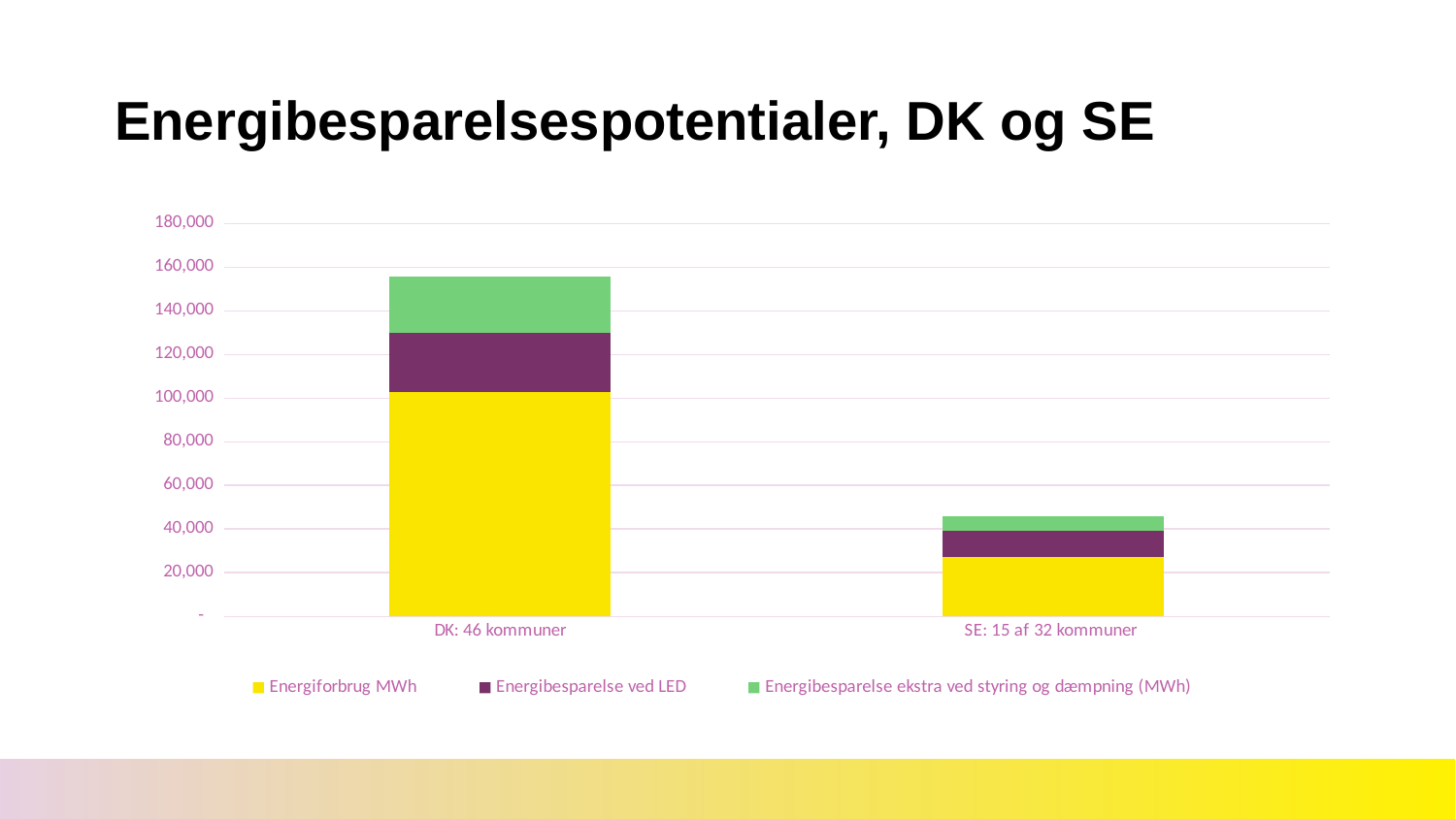
Is the Energiforbrug MWh value for DK: 46 kommuner greater or less than 80,000? greater Is the Energiforbrug MWh value for SE: 15 af 32 kommuner greater or less than 40,000? less What kind of chart is shown on the slide? Stacked bar chart How many categories are shown on the x axis of the chart? 2 Is the total stacked bar for SE: 15 af 32 kommuner greater or less than 60,000? less Which category has the taller stacked bar, DK: 46 kommuner or SE: 15 af 32 kommuner? DK: 46 kommuner What is the title of the slide containing the chart? Energibesparelsespotentialer, DK og SE Which category has the lowest total stacked bar? SE: 15 af 32 kommuner Which category has the larger Energibesparelse ved LED segment, DK: 46 kommuner or SE: 15 af 32 kommuner? DK: 46 kommuner How many series does the chart's legend list? 3 Which series is shown in green in the chart's legend? Energibesparelse ekstra ved styring og dæmpning (MWh)